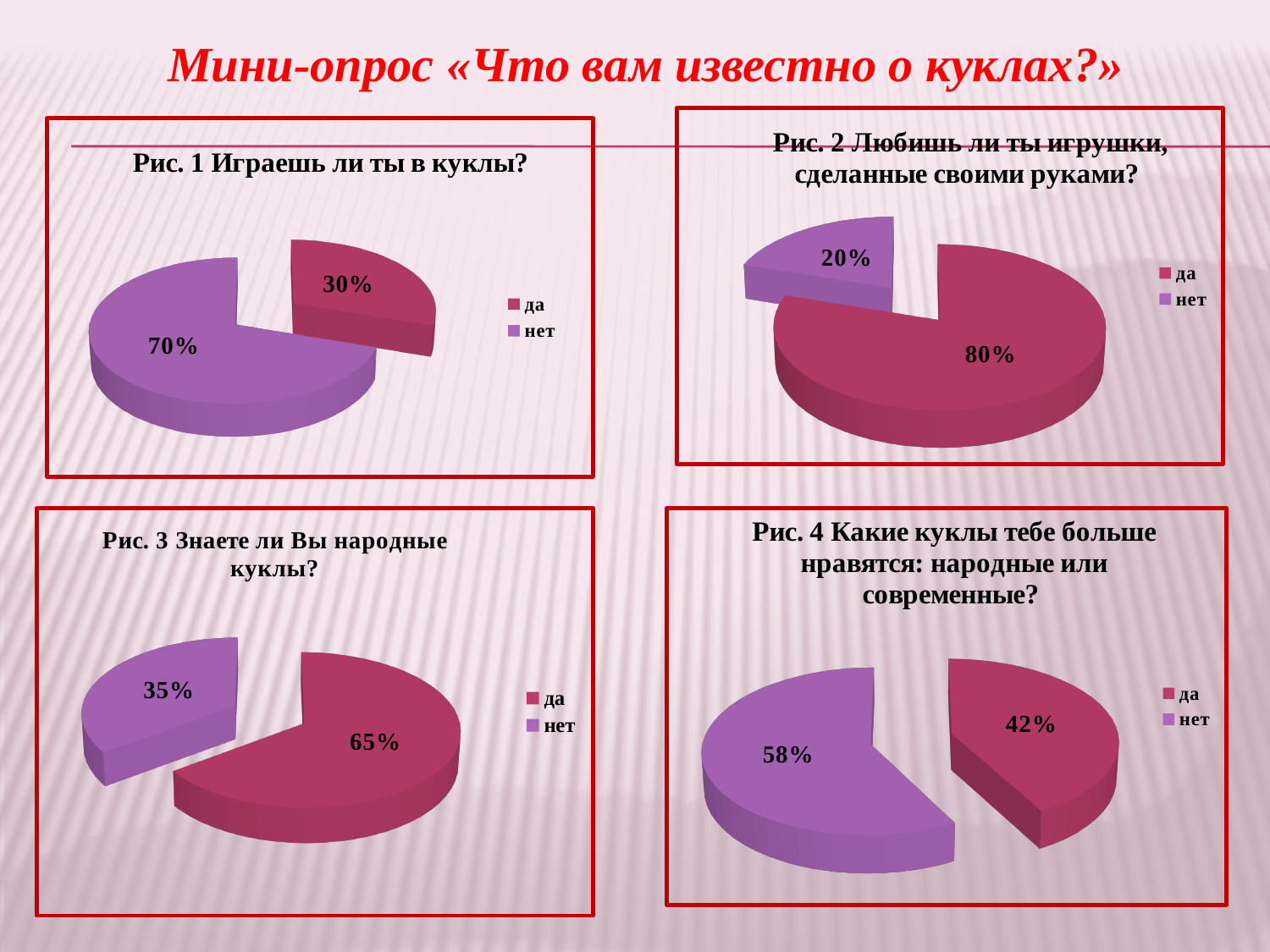
In the chart "Рис. 4 Какие куклы тебе больше нравятся: народные или современные?", what is the value for "да"? 42% In the chart "Рис. 1 Играешь ли ты в куклы?", what is the value for "нет"? 70% What kind of chart is "Рис. 2 Любишь ли ты игрушки, сделанные своими руками?"? Pie chart In the chart "Рис. 3 Знаете ли Вы народные куклы?", what is the difference between the "да" and "нет" values? 30% In the chart "Рис. 2 Любишь ли ты игрушки, сделанные своими руками?", what is the value for "да"? 80% In the chart "Рис. 2 Любишь ли ты игрушки, сделанные своими руками?", which slice is the smallest? нет In the chart "Рис. 4 Какие куклы тебе больше нравятся: народные или современные?", which is larger, "да" or "нет"? нет How many entries does the legend of the chart "Рис. 4 Какие куклы тебе больше нравятся: народные или современные?" list? 2 In the chart "Рис. 3 Знаете ли Вы народные куклы?", which slice is the largest? да In the chart "Рис. 3 Знаете ли Вы народные куклы?", what is the value for "нет"? 35% In the chart "Рис. 1 Играешь ли ты в куклы?", what share of the pie is labelled "да"? 30% In the chart "Рис. 1 Играешь ли ты в куклы?", what is the difference between the "нет" and "да" values? 40%